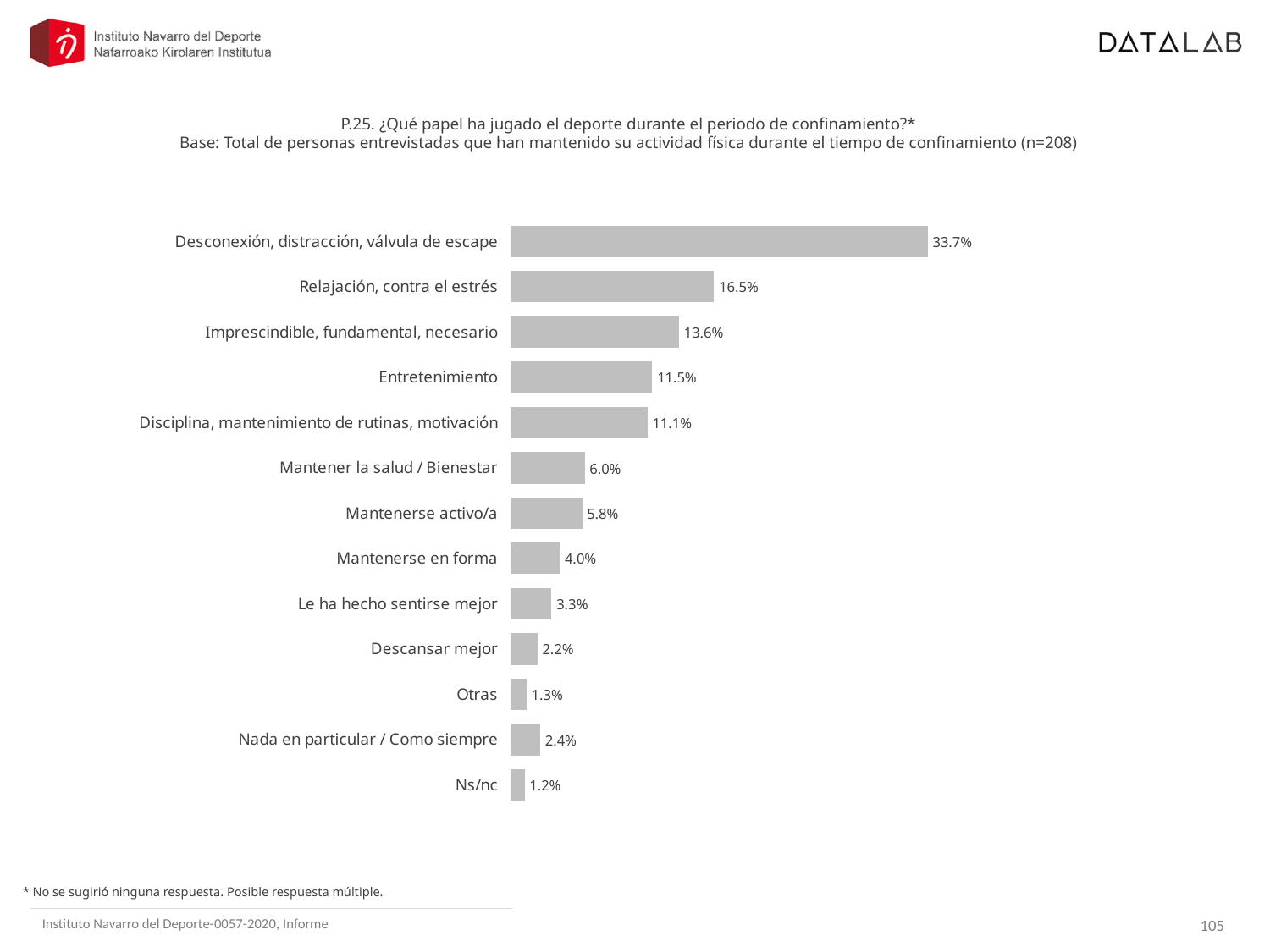
What is the value for "Entretenimiento"? 11.5% Which is larger, "Otras" or "Nada en particular / Como siempre"? Nada en particular / Como siempre What is the value for "Mantenerse en forma"? 4.0% Which category has the highest value? Desconexión, distracción, válvula de escape Which category has the lowest value? Ns/nc What is the value for "Descansar mejor"? 2.2% What is the value for "Desconexión, distracción, válvula de escape"? 33.7% Which is larger, "Mantener la salud / Bienestar" or "Le ha hecho sentirse mejor"? Mantener la salud / Bienestar How many categories are shown in the chart? 13 What is the difference between "Relajación, contra el estrés" and "Imprescindible, fundamental, necesario"? 2.9% What kind of chart is shown on the slide? Bar chart What is the difference between "Desconexión, distracción, válvula de escape" and "Relajación, contra el estrés"? 17.2%